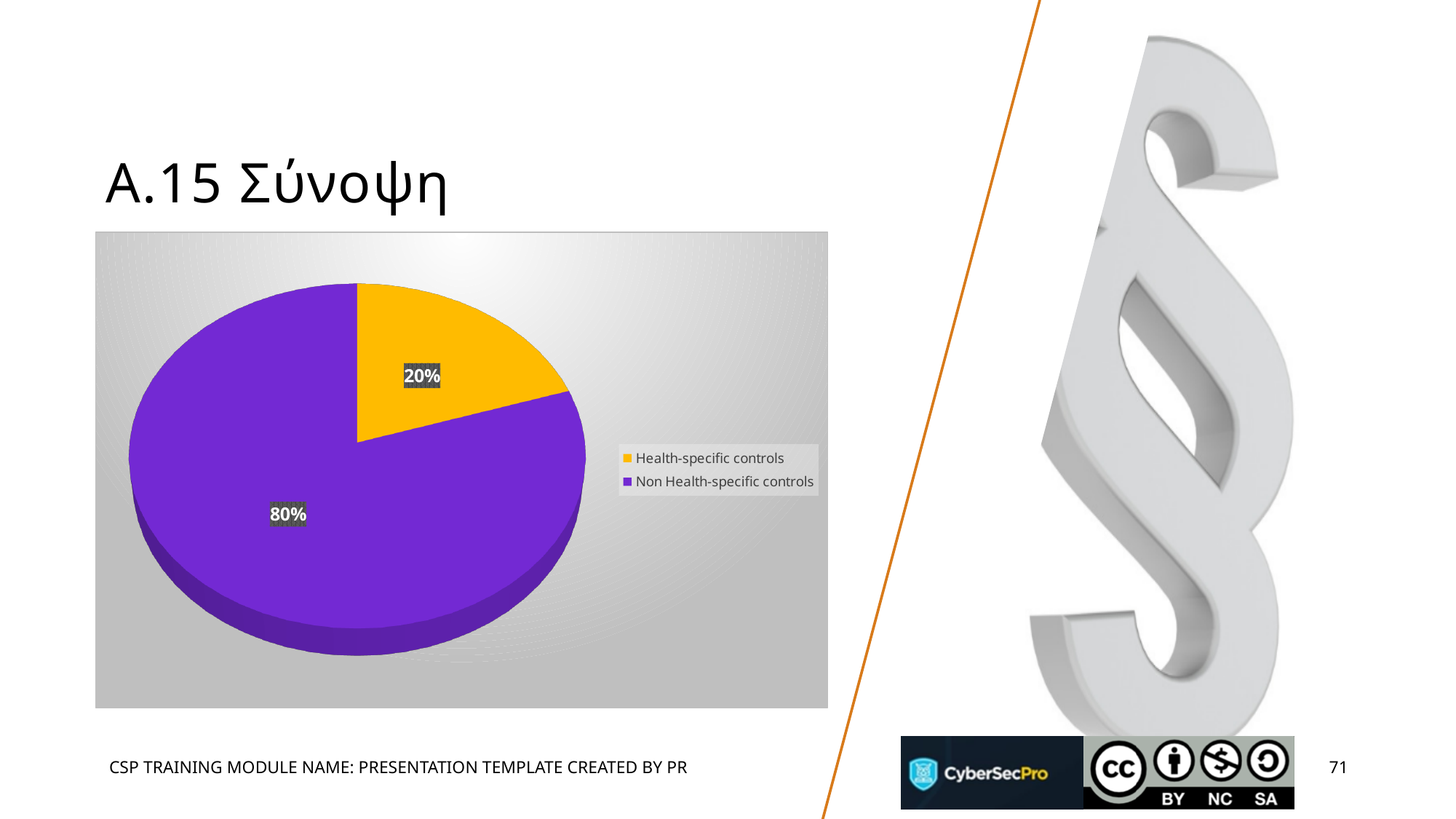
Which is larger: the share for Health-specific controls or the share for Non Health-specific controls? Non Health-specific controls Which category has the smallest share of the pie chart? Health-specific controls How many slices does the pie chart have? 2 What percentage of the pie chart is Health-specific controls? 20% What colour is the Non Health-specific controls slice? Purple Which category has the largest share of the pie chart? Non Health-specific controls How many entries does the legend list? 2 What colour is the Health-specific controls slice? Orange What share of the pie does the Health-specific controls slice represent? 20% What percentage of the pie chart is Non Health-specific controls? 80% What is the difference in percentage points between Non Health-specific controls and Health-specific controls? 60 What kind of chart is shown on the slide? Pie chart